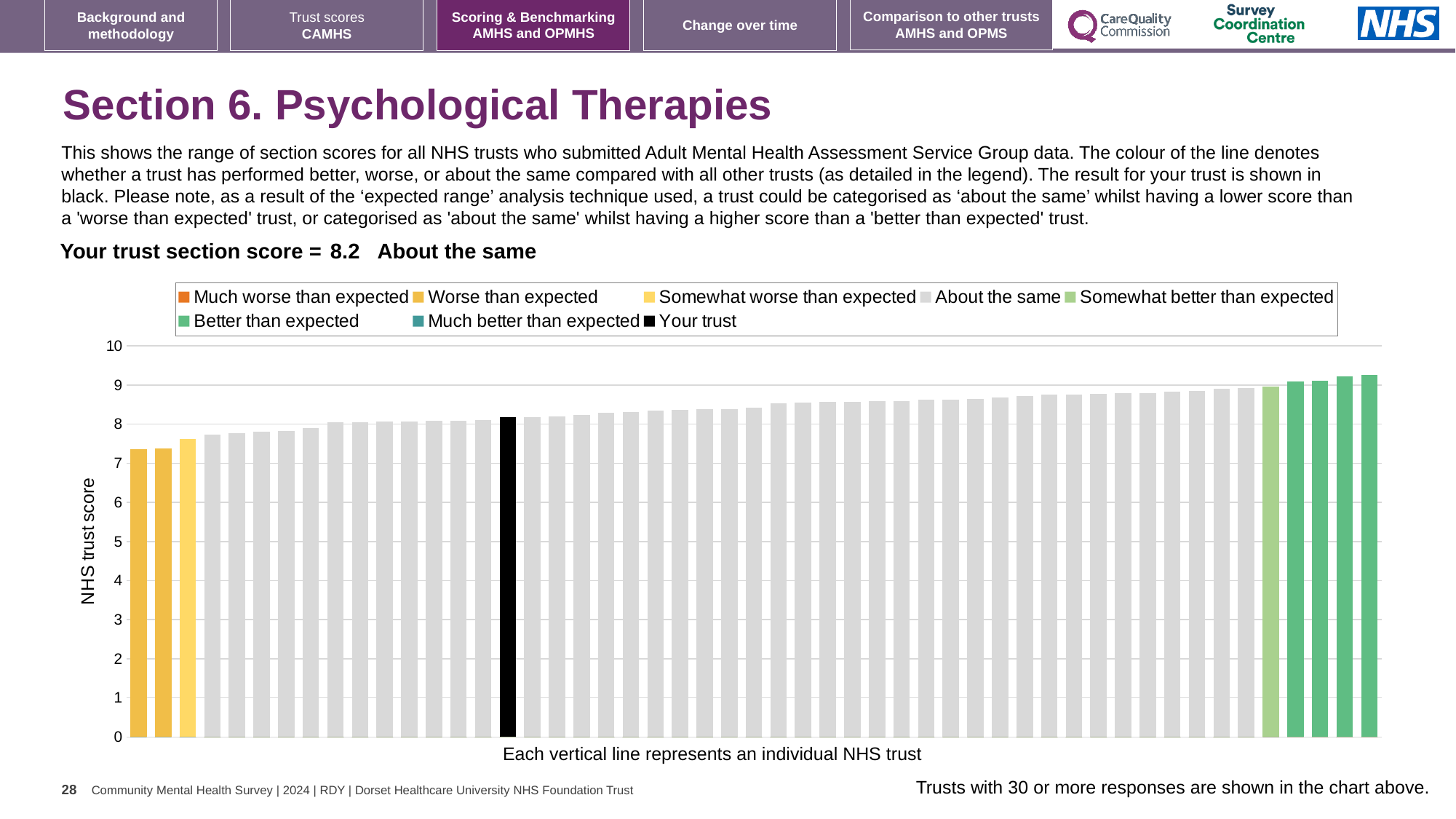
Which is larger, the leftmost bar or the rightmost bar? the rightmost bar How many entries does the chart legend list? 8 Is the value of the rightmost bar greater or less than 9? greater How many bars are coloured as 'Worse than expected' (orange-yellow)? 2 Do the bar values rise or fall from left to right across the chart? rise Is the value of the leftmost bar greater or less than 8? less What is the label on the vertical axis of the chart? NHS trust score Is the value of the black 'Your trust' bar greater or less than 8? greater What is the section score for your trust shown on the slide? 8.2 What kind of chart is shown on the slide? bar chart How many bars are coloured as 'Better than expected' (dark green)? 4 What colour is the bar representing your trust? black